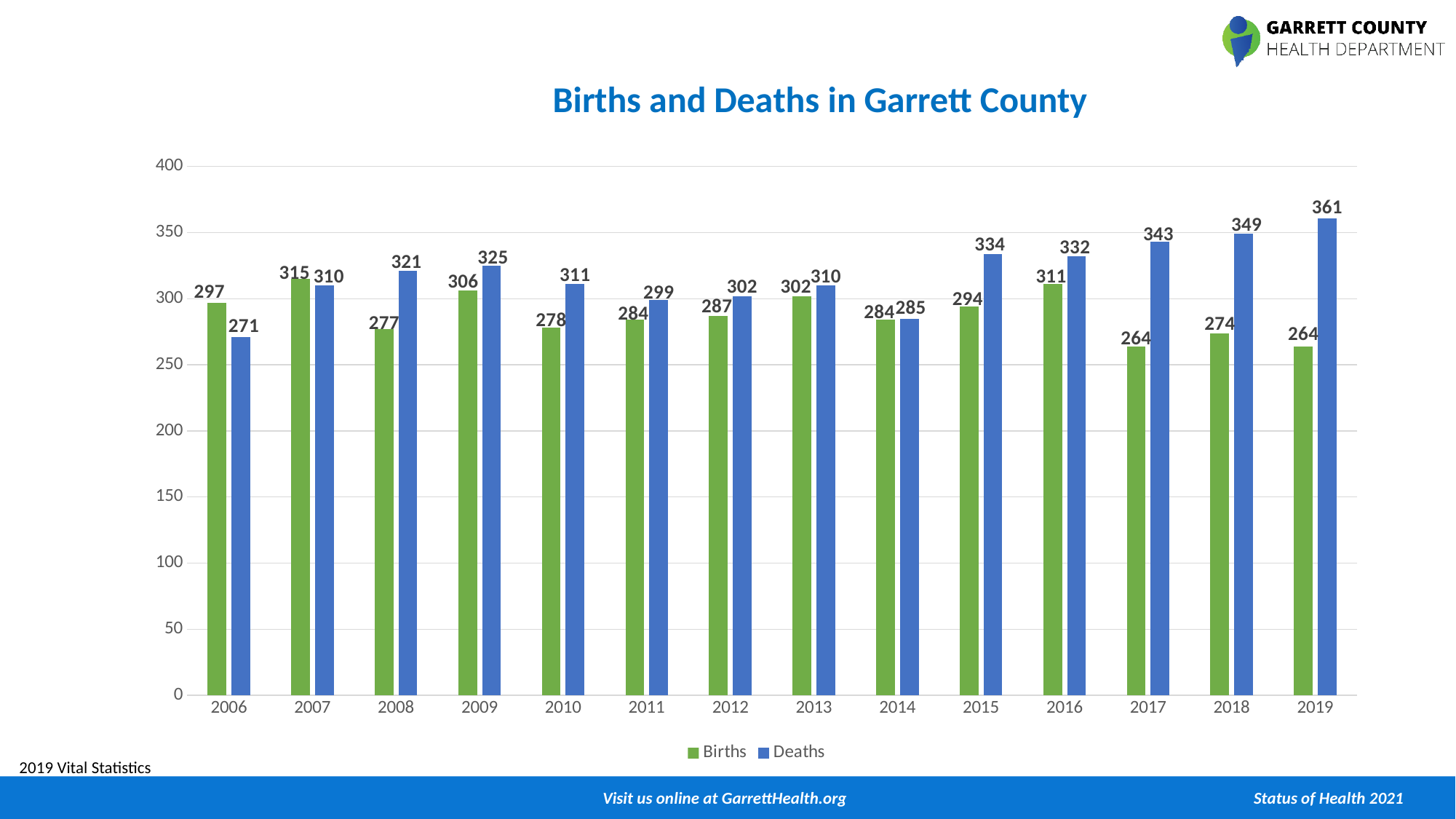
What kind of chart is shown on the slide? Bar chart Is the number of deaths in 2018 greater or less than 300? greater How many deaths were there in Garrett County in 2019? 361 What is the title of the chart? Births and Deaths in Garrett County What is the difference between deaths and births in 2019? 97 Were there more births or deaths in 2006? Births Which year had the lowest number of deaths? 2006 How many years are shown on the x axis? 14 How many births were there in Garrett County in 2009? 306 Which year had the highest number of deaths? 2019 How many series does the legend list? 2 Which year had the highest number of births? 2007